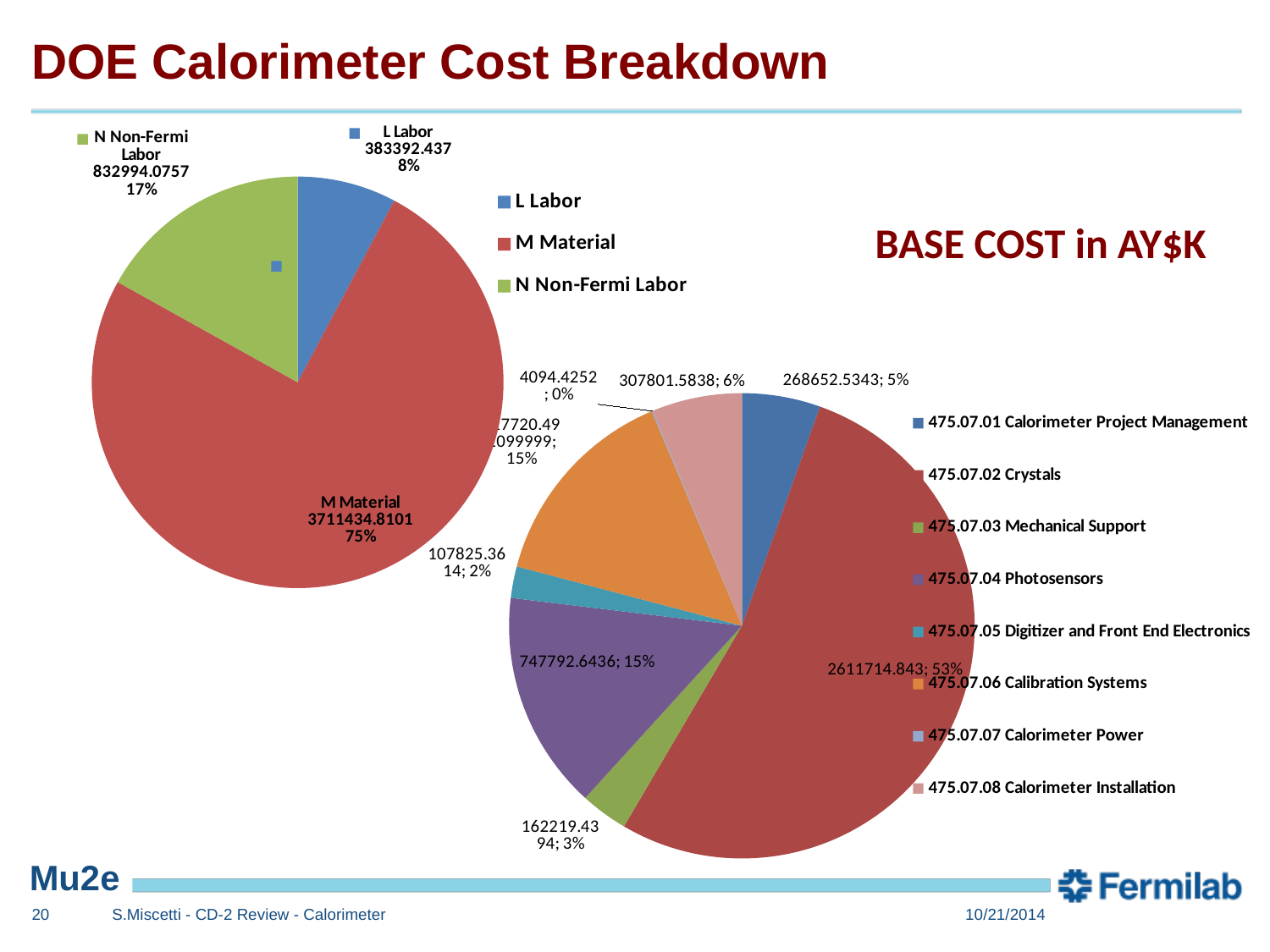
In the right pie chart (475.07.xx WBS breakdown), what is the value shown for 475.07.04 Photosensors? 747792.6436 What kind of chart is used for the DOE Calorimeter Cost Breakdown on this slide? Pie chart In the right pie chart (475.07.xx WBS breakdown), what is the value shown for 475.07.01 Calorimeter Project Management? 268652.5343 How many entries does the legend of the right pie chart (475.07.xx WBS breakdown) list? 8 In the left pie chart (L Labor / M Material / N Non-Fermi Labor), what is the value shown for M Material? 3711434.8101 How many categories does the left pie chart (L Labor / M Material / N Non-Fermi Labor) show? 3 In the left pie chart (L Labor / M Material / N Non-Fermi Labor), what percentage share does N Non-Fermi Labor have? 17% In the left pie chart (L Labor / M Material / N Non-Fermi Labor), which category has the largest slice? M Material In the right pie chart (475.07.xx WBS breakdown), what percentage share does 475.07.02 Crystals have? 53% In the left pie chart (L Labor / M Material / N Non-Fermi Labor), which category has the smallest slice? L Labor In the right pie chart (475.07.xx WBS breakdown), which is larger: 475.07.04 Photosensors or 475.07.03 Mechanical Support? 475.07.04 Photosensors In the right pie chart (475.07.xx WBS breakdown), which category has the smallest slice? 475.07.07 Calorimeter Power